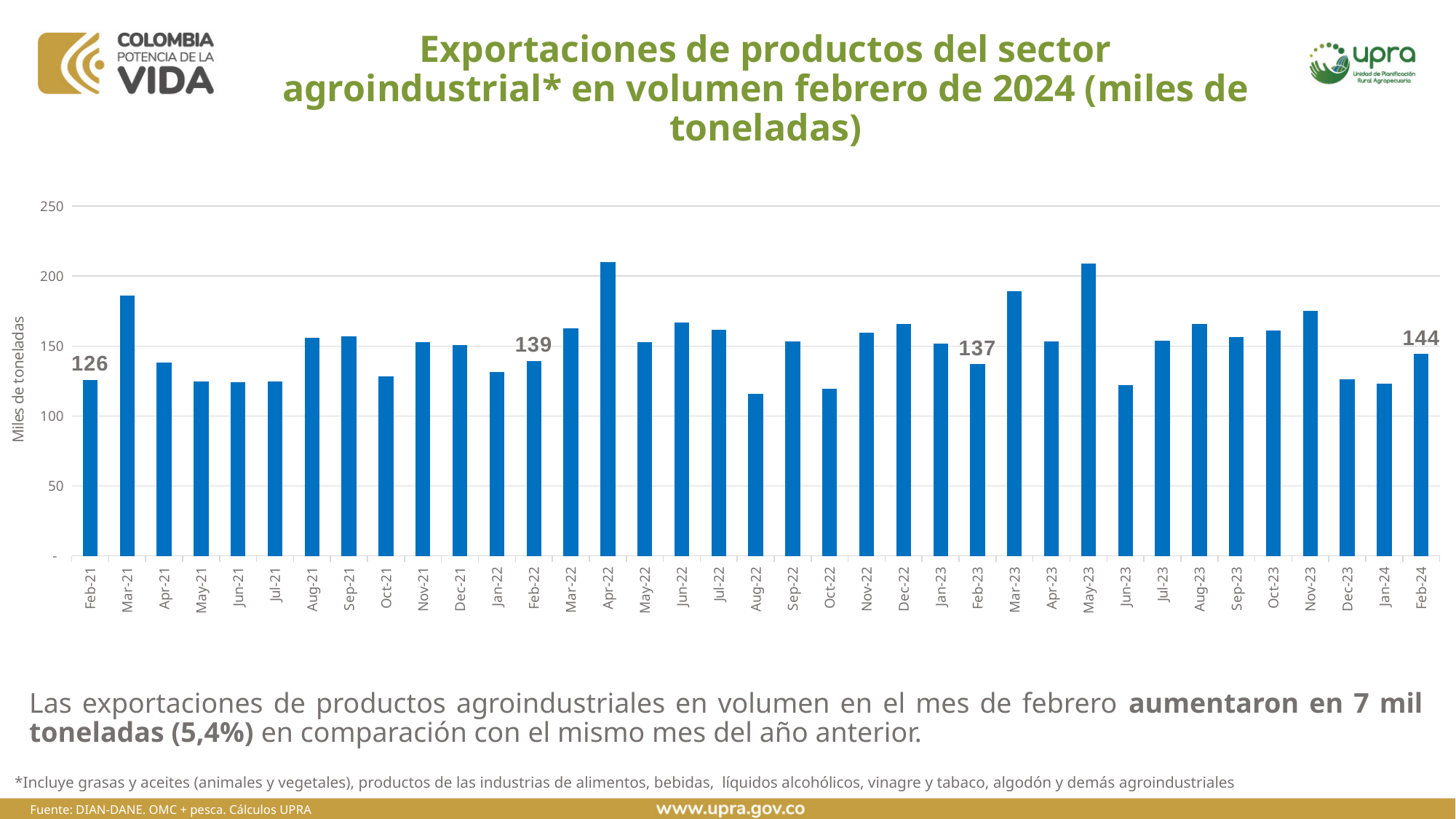
What type of chart is shown on the slide? bar chart What is the value for Feb-21? 126 What is the difference between the values for Feb-22 and Feb-21? 13 Is the value for Apr-22 greater or less than 200? greater What is the value for Feb-23? 137 What is the value for Feb-24? 144 Is the value for Jun-23 greater or less than 150? less Which is larger, the value for Feb-22 or the value for Feb-23? Feb-22 What is the value for Feb-22? 139 What is the difference between the values for Feb-24 and Feb-23? 7 What is the label of the vertical axis? Miles de toneladas How many monthly bars are plotted in the chart? 37